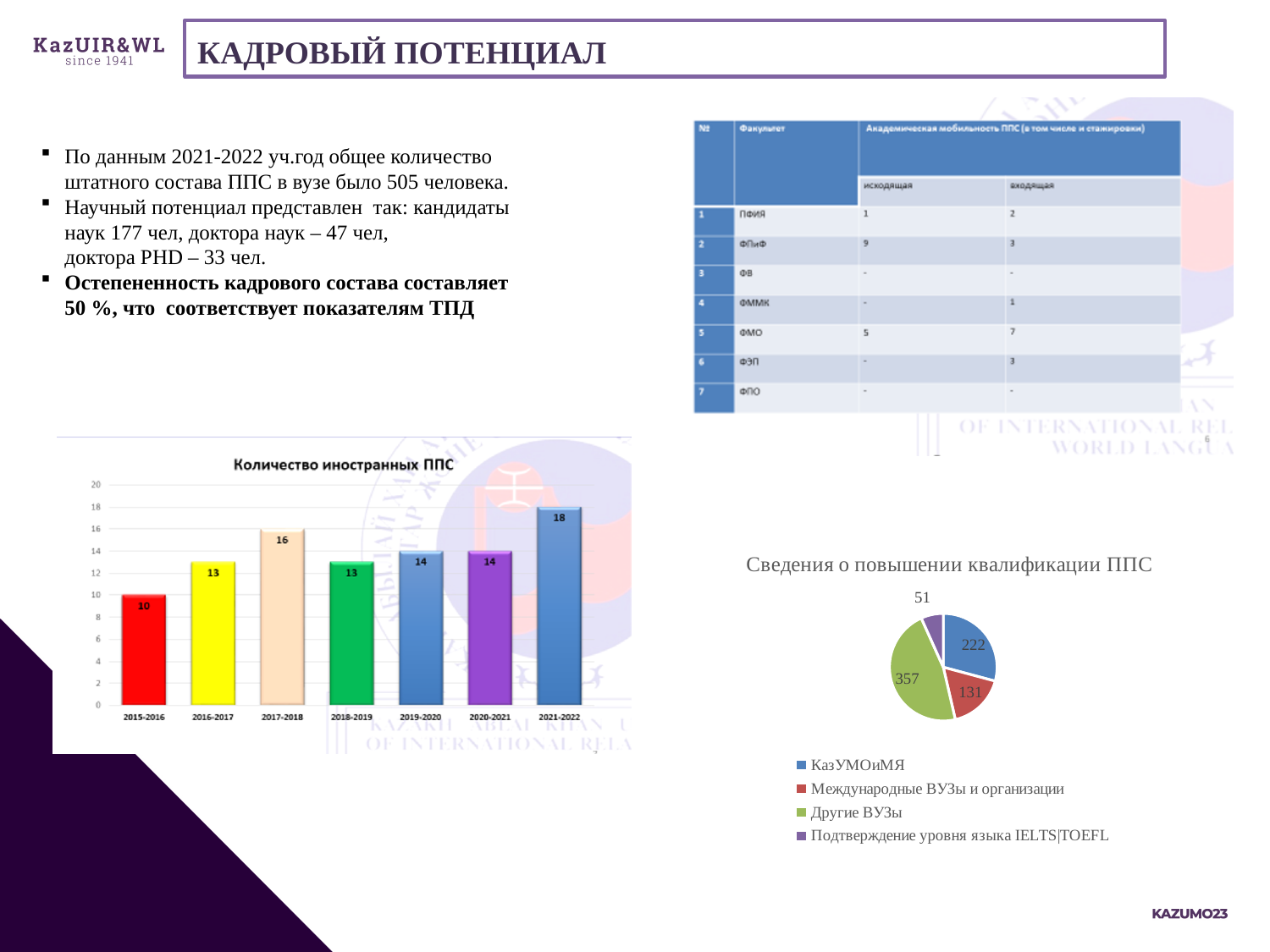
In the bar chart 'Количество иностранных ППС', what is the difference between the values for 2021-2022 and 2015-2016? 8 What kind of chart is 'Количество иностранных ППС'? bar chart In the bar chart 'Количество иностранных ППС', which year has the highest value? 2021-2022 In the pie chart 'Сведения о повышении квалификации ППС', what is the value for Подтверждение уровня языка IELTS|TOEFL? 51 In the pie chart 'Сведения о повышении квалификации ППС', which category has the largest slice? Другие ВУЗы In the bar chart 'Количество иностранных ППС', which is larger: the value for 2017-2018 or the value for 2019-2020? 2017-2018 In the bar chart 'Количество иностранных ППС', which year has the lowest value? 2015-2016 In the bar chart 'Количество иностранных ППС', what is the value for 2017-2018? 16 In the bar chart 'Количество иностранных ППС', what is the value for 2015-2016? 10 In the pie chart 'Сведения о повышении квалификации ППС', what is the value for Другие ВУЗы? 357 How many years (categories) are shown in the bar chart 'Количество иностранных ППС'? 7 How many entries does the legend of the pie chart 'Сведения о повышении квалификации ППС' list? 4